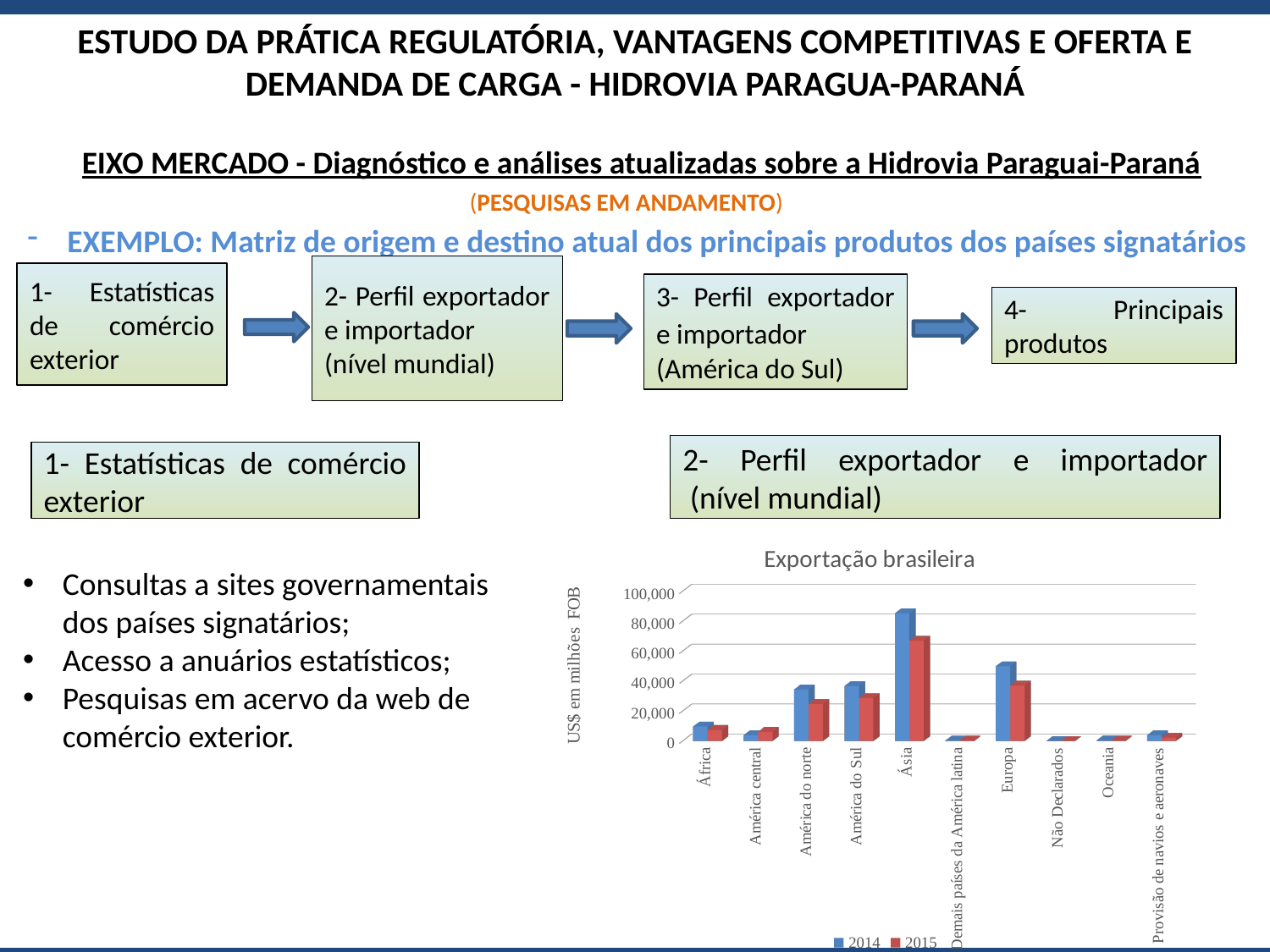
Which years are listed in the chart legend? 2014 and 2015 How many series does the chart legend list? 2 What is the title of the chart on the slide? Exportação brasileira Is the 2015 value for Ásia greater or less than 60,000? greater How many categories are shown on the x axis of the chart? 10 Which category has the highest export value in the chart? Ásia Is the 2014 value for América do norte greater or less than 40,000? less For Ásia, which year has the larger export value, 2014 or 2015? 2014 Is the 2014 value for Europa greater or less than 40,000? greater In 2014, which has the larger export value, Europa or América do Sul? Europa What kind of chart is shown on the slide? bar chart